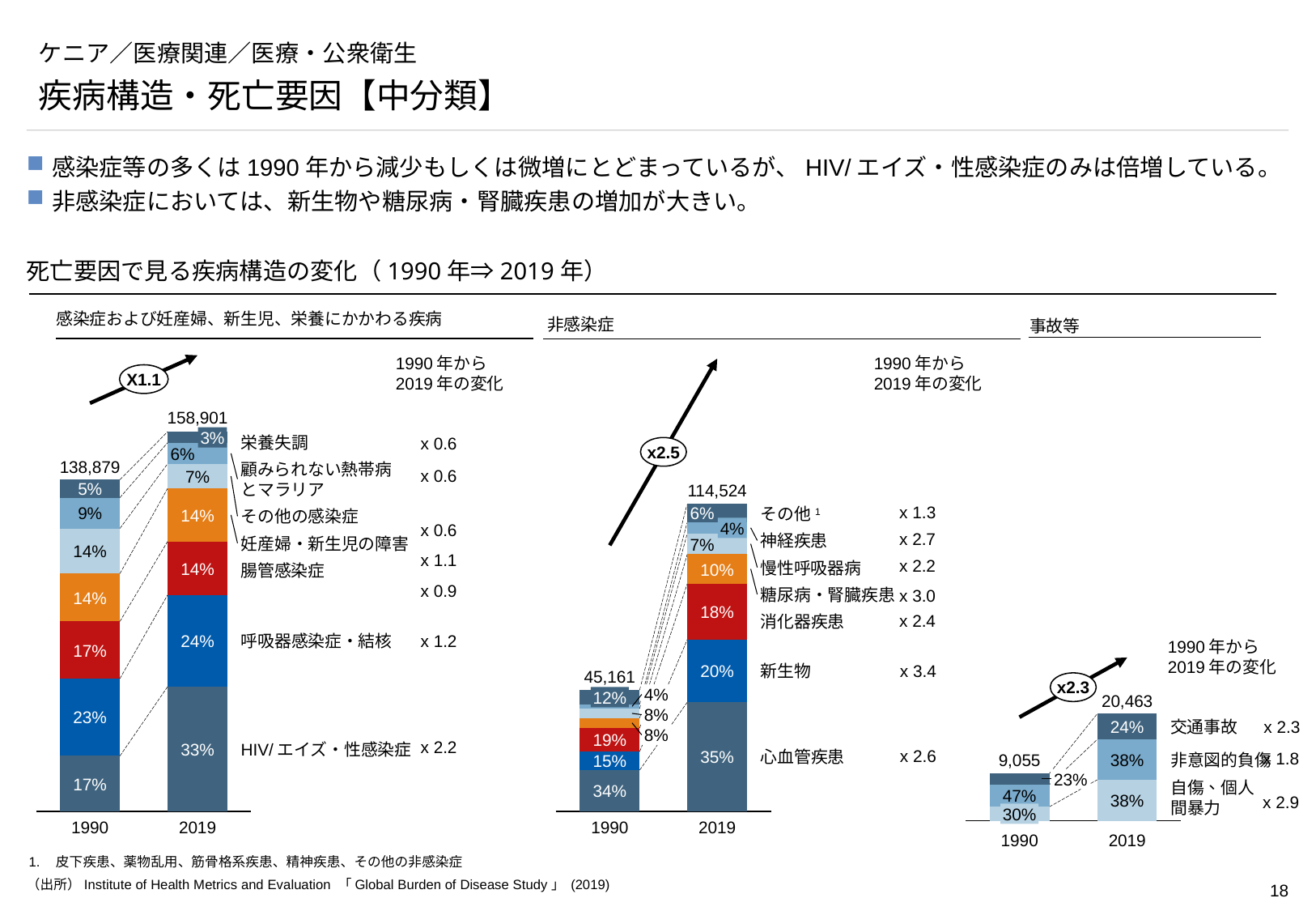
In the 非感染症 chart in the middle, what is the difference between the 2019 total and the 1990 total? 69,363 In the 非感染症 chart, which category has the largest share of the 2019 bar? 心血管疾患 In the 事故等 chart on the right, what is the total value shown above the 1990 bar? 9,055 In the 事故等 chart on the right, what percentage share does 交通事故 have in the 2019 bar? 24% In the left chart, what percentage share does HIV/エイズ・性感染症 have in the 2019 bar? 33% In the 感染症および妊産婦、新生児、栄養にかかわる疾病 chart on the left, what is the total value shown above the 1990 bar? 138,879 In the 非感染症 chart, what is the change multiplier from 1990 to 2019 shown for 新生物? x 3.4 What kind of chart is used in the 事故等 chart on the right? stacked bar chart In the left chart, what is the change multiplier from 1990 to 2019 shown for HIV/エイズ・性感染症? x 2.2 Which is larger: the 2019 total in the 事故等 chart or the 1990 total in the 非感染症 chart? the 1990 total in the 非感染症 chart In the 感染症および妊産婦、新生児、栄養にかかわる疾病 chart on the left, what is the total value shown above the 2019 bar? 158,901 In the 非感染症 chart in the middle, what is the total value shown above the 2019 bar? 114,524